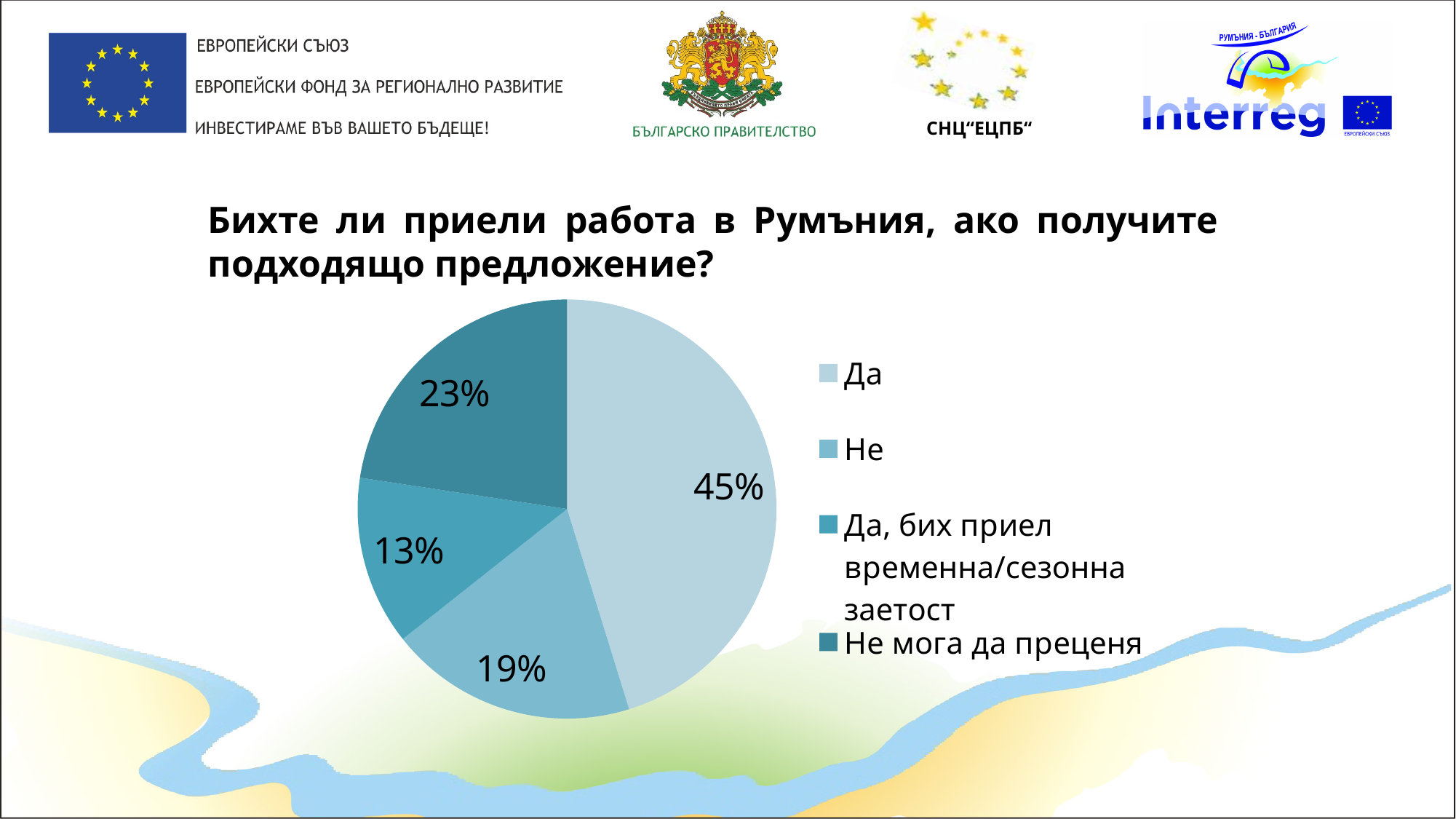
What kind of chart is shown on the slide? pie chart What is the difference in percentage points between "Не мога да преценя" and "Да, бих приел временна/сезонна заетост"? 10 What is the difference in percentage points between "Да" and "Не"? 26 Which category has the smallest slice of the pie? Да, бих приел временна/сезонна заетост How many slices does the pie chart have? 4 What is the title of the chart on the slide? Бихте ли приели работа в Румъния, ако получите подходящо предложение? What share of the pie does "Не мога да преценя" have? 23% What share of the pie does "Да" have? 45% Which category has the largest slice of the pie? Да What share of the pie does "Не" have? 19% What share of the pie does "Да, бих приел временна/сезонна заетост" have? 13% Which is larger, the slice for "Не" or the slice for "Не мога да преценя"? Не мога да преценя